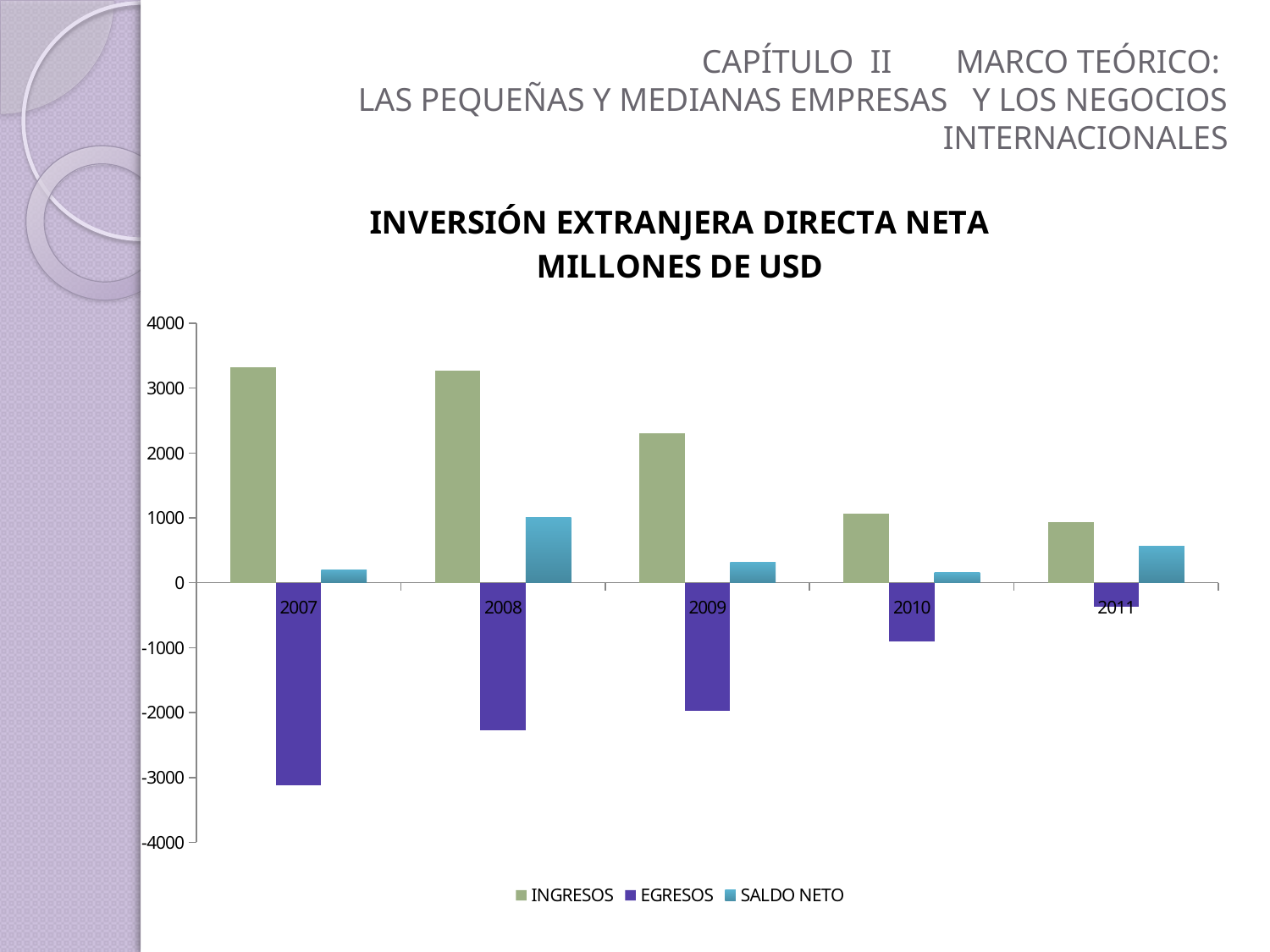
Do the INGRESOS values rise or fall from 2007 to 2011? fall Which year has the most negative EGRESOS value? 2007 What kind of chart is shown on the slide? bar chart How many years are shown on the x axis? 5 Which year has the highest SALDO NETO value? 2008 Is the INGRESOS value for 2007 greater or less than 3000? greater Is the INGRESOS value for 2009 greater or less than 2000? greater How many series does the legend list? 3 What is the title of the chart? INVERSIÓN EXTRANJERA DIRECTA NETA MILLONES DE USD Which is larger, the INGRESOS value for 2009 or for 2010? 2009 Is the EGRESOS value for 2007 greater or less than -3000? less